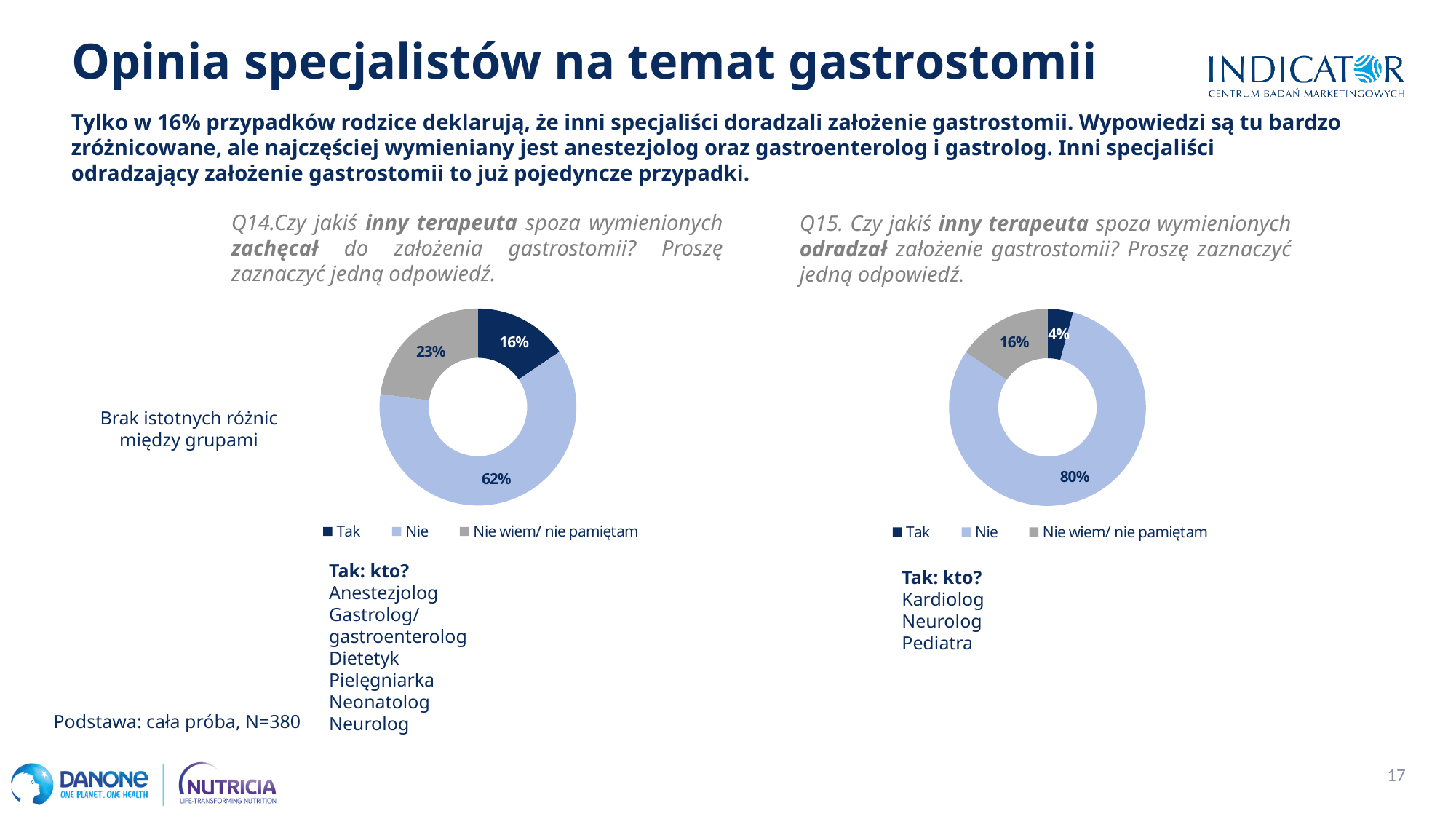
In the left chart (Q14), what is the difference between the "Nie" and "Tak" shares? 46 percentage points What type of chart is used on this slide? Doughnut (pie) chart In the right chart (Q15), which answer has the largest share? Nie How many categories does the legend of the left chart (Q14) list? 3 In the left chart (Q14), what percentage of respondents answered "Nie"? 62% In the left chart (Q14), which answer has the smallest share? Tak In the right chart (Q15), what percentage of respondents answered "Nie"? 80% In the right chart (Q15), what is the difference between the "Nie wiem/ nie pamiętam" and "Tak" shares? 12 percentage points In the left chart (Q14), what percentage answered "Nie wiem/ nie pamiętam"? 23% Which chart has the larger "Tak" share, the left chart (Q14) or the right chart (Q15)? The left chart (Q14) In the right chart (Q15), what percentage of respondents answered "Tak"? 4% In the left chart (Q14), what percentage of respondents answered "Tak"? 16%